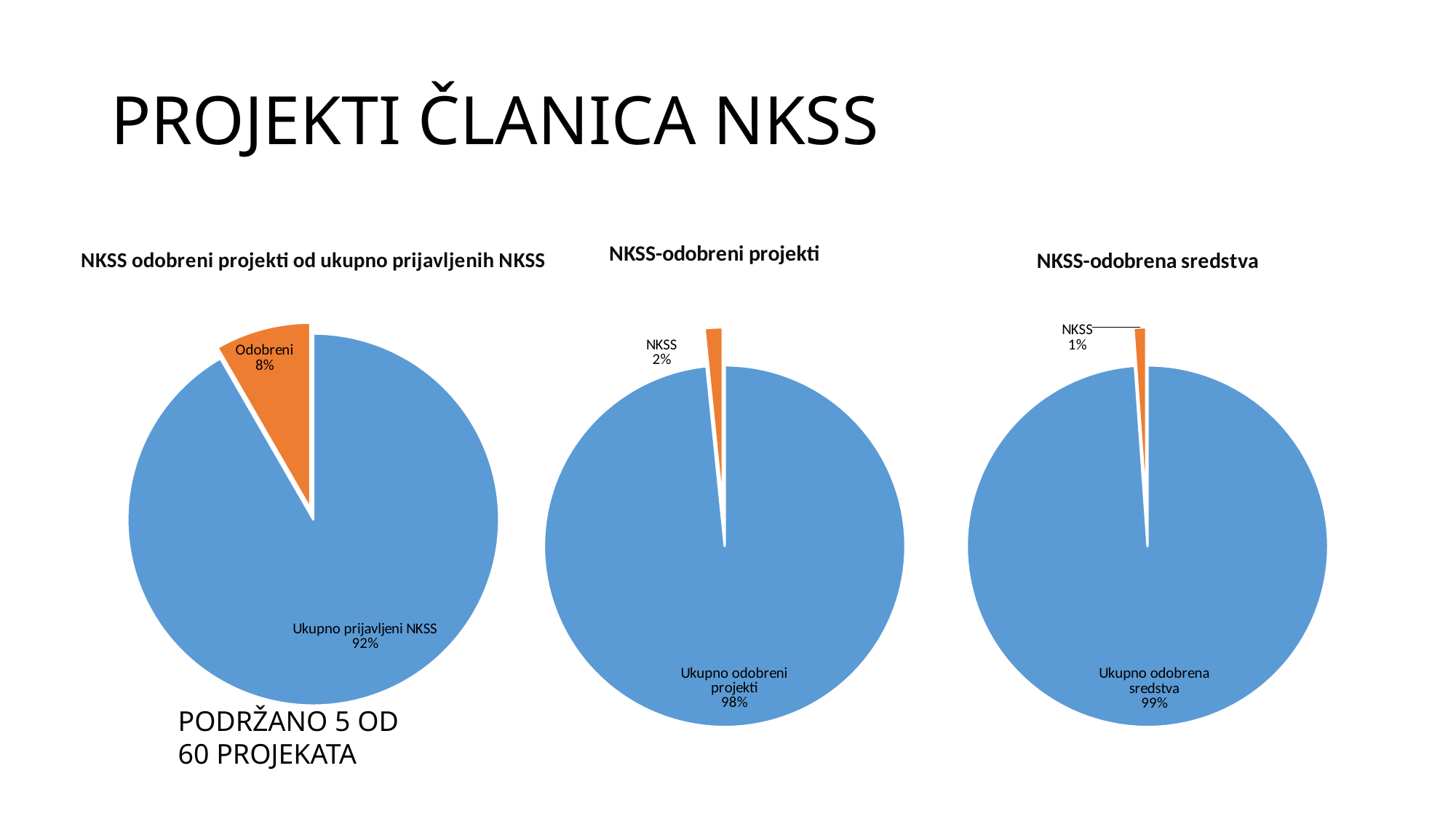
In the chart titled 'NKSS-odobrena sredstva', what share does the 'NKSS' slice have? 1% What kind of chart is the chart titled 'NKSS-odobrena sredstva'? Pie chart In the chart titled 'NKSS-odobreni projekti', what share does the 'NKSS' slice have? 2% How many slices does the chart titled 'NKSS-odobreni projekti' have? 2 In the chart titled 'NKSS-odobreni projekti', what share does the 'Ukupno odobreni projekti' slice have? 98% In the chart titled 'NKSS odobreni projekti od ukupno prijavljenih NKSS', which slice is the largest? Ukupno prijavljeni NKSS How many charts are shown on the slide? 3 In the chart titled 'NKSS-odobreni projekti', which slice is the smallest? NKSS In the chart titled 'NKSS odobreni projekti od ukupno prijavljenih NKSS', what is the difference in percentage points between the 'Ukupno prijavljeni NKSS' slice and the 'Odobreni' slice? 84